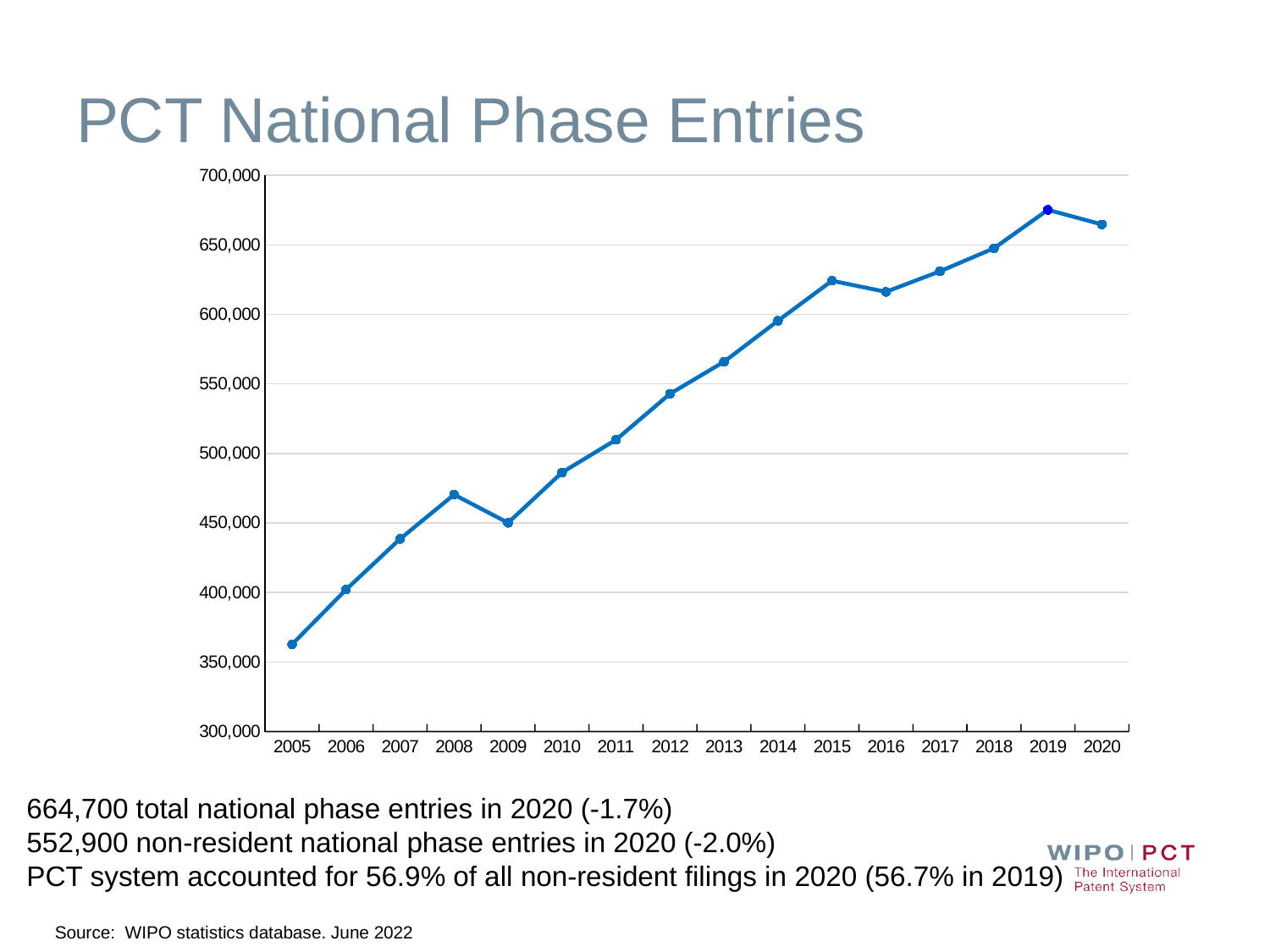
In which year is the number of PCT national phase entries lowest? 2005 Which year has more PCT national phase entries, 2008 or 2009? 2008 How many total national phase entries were there in 2020, according to the slide? 664,700 Is the value for 2008 greater or less than 450,000? greater Which year has more PCT national phase entries, 2015 or 2016? 2015 Do PCT national phase entries generally rise or fall from 2005 to 2020? Rise In which year is the number of PCT national phase entries highest? 2019 Is the value for 2019 greater or less than 650,000? greater What kind of chart is shown on the slide? Line chart Is the value for 2005 greater or less than 400,000? less How many years are plotted on the x axis of the chart? 16 What is the title of the chart? PCT National Phase Entries